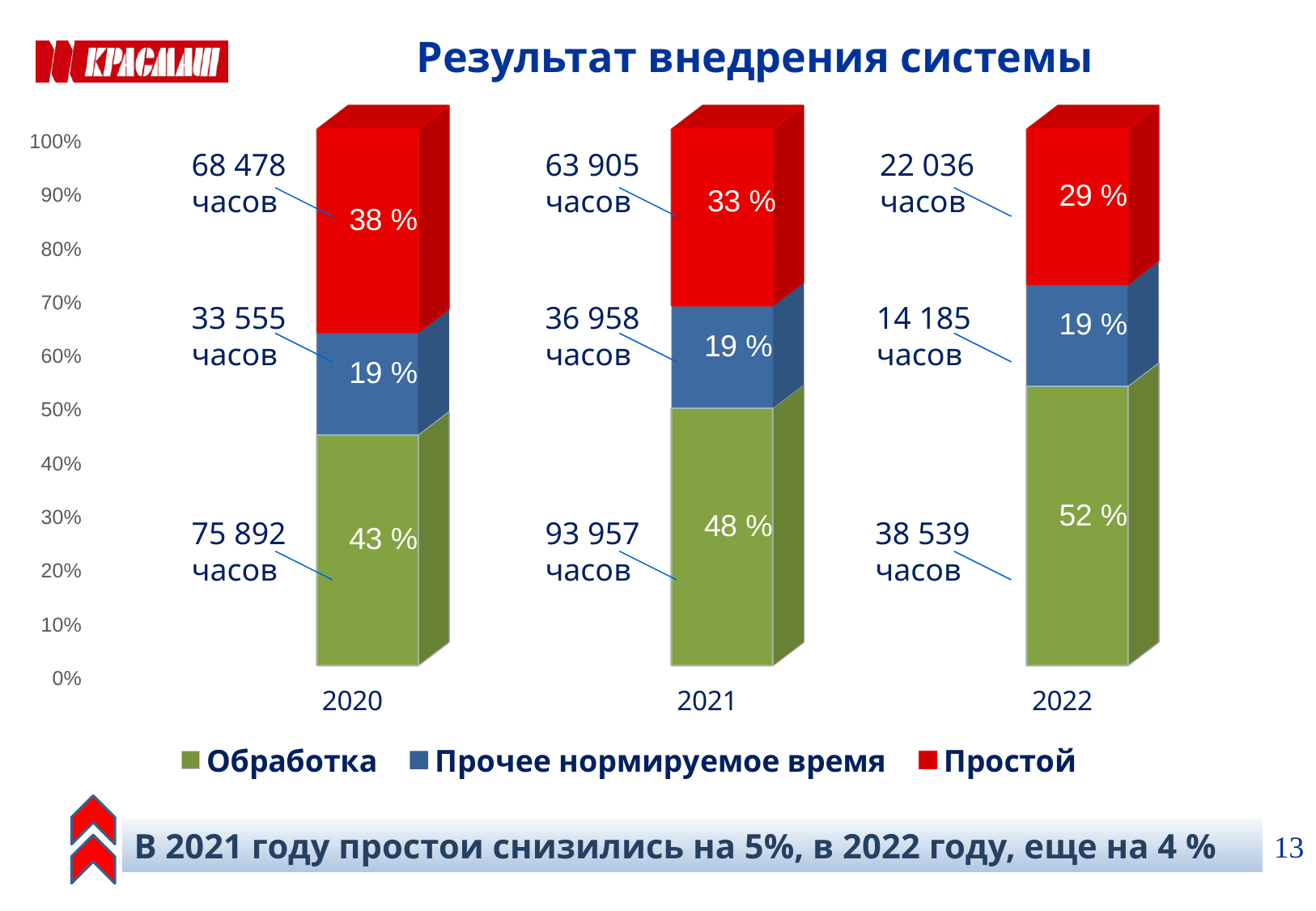
In which year is the Простой share the lowest? 2022 How many series does the legend list? 3 In which year is the Обработка share the highest? 2022 How many years are shown on the x axis? 3 Does the Простой share rise or fall from 2020 to 2022? fall What percentage does the Обработка segment show for 2022? 52 % By how many percentage points did the Простой share fall from 2020 to 2021? 5 How many hours are annotated for the Обработка segment in 2020? 75 892 часов What percentage does the Простой segment show for 2020? 38 % How many hours are annotated for the Простой segment in 2021? 63 905 часов What kind of chart is shown on the slide? stacked bar chart Which is larger in 2021: the Обработка share or the Простой share? Обработка